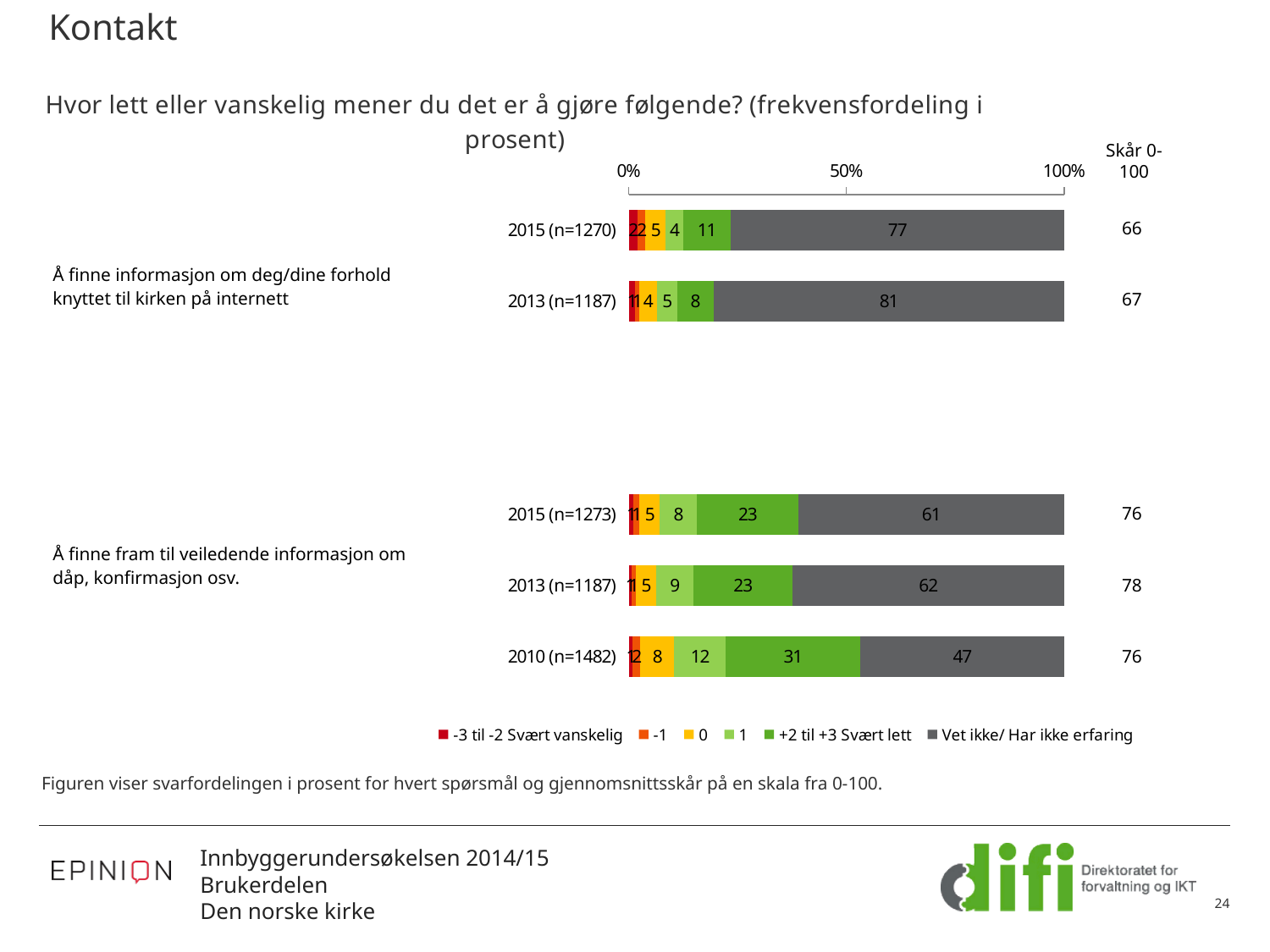
What is the label of the last legend entry? Vet ikke/ Har ikke erfaring What is the Skår 0-100 value for 2013 (n=1187) under 'Å finne fram til veiledende informasjon om dåp, konfirmasjon osv.'? 78 Which bar has the lowest 'Vet ikke/ Har ikke erfaring' value? 2010 (n=1482) What kind of chart is shown on the slide? stacked bar chart How many bars are plotted in the chart in total? 5 What is the 'Vet ikke/ Har ikke erfaring' value for 2015 (n=1270) under 'Å finne informasjon om deg/dine forhold knyttet til kirken på internett'? 77 Which is larger: the '+2 til +3 Svært lett' value for 2015 (n=1270) or for 2013 (n=1187) under 'Å finne informasjon om deg/dine forhold knyttet til kirken på internett'? 2015 (n=1270) What is the 'Vet ikke/ Har ikke erfaring' value for 2010 (n=1482) under 'Å finne fram til veiledende informasjon om dåp, konfirmasjon osv.'? 47 What is the difference between the '+2 til +3 Svært lett' values for 2010 (n=1482) and 2015 (n=1273) under 'Å finne fram til veiledende informasjon om dåp, konfirmasjon osv.'? 8 Which bar has the highest 'Vet ikke/ Har ikke erfaring' value? 2013 (n=1187) under 'Å finne informasjon om deg/dine forhold knyttet til kirken på internett' How many series does the legend list? 6 What is the '+2 til +3 Svært lett' value for 2010 (n=1482) under 'Å finne fram til veiledende informasjon om dåp, konfirmasjon osv.'? 31